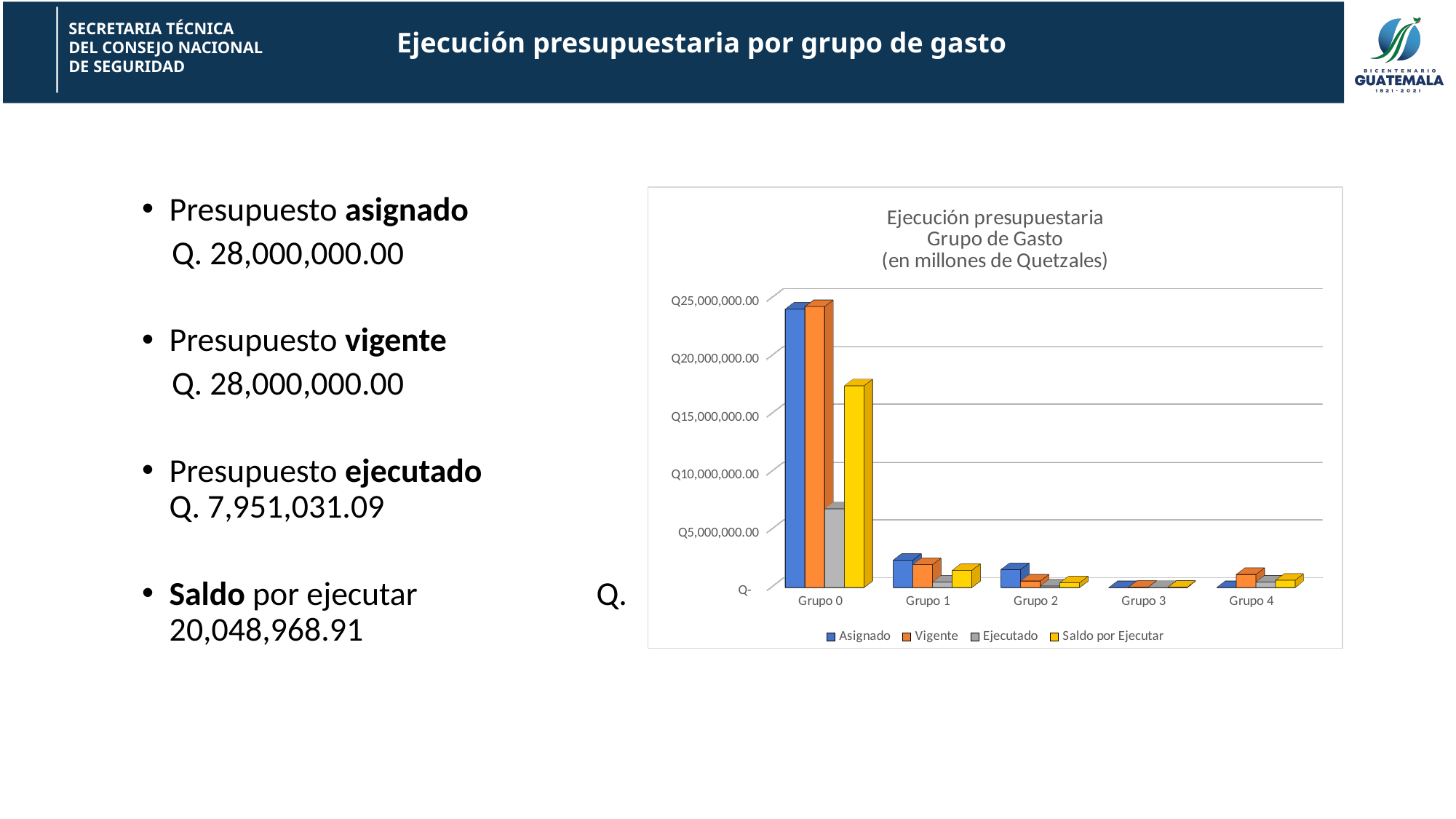
For Grupo 0, which is larger: the Vigente value or the Ejecutado value? Vigente Is the Ejecutado value for Grupo 0 greater or less than Q10,000,000.00? less What kind of chart is shown on the slide? Bar chart Which series is shown in yellow in the chart legend? Saldo por Ejecutar Is the Saldo por Ejecutar value for Grupo 0 greater or less than Q20,000,000.00? less Is the Asignado value for Grupo 1 greater or less than Q5,000,000.00? less How many groups (categories) are shown on the x axis of the chart? 5 How many series does the chart legend list? 4 What is the title of the chart? Ejecución presupuestaria Grupo de Gasto (en millones de Quetzales) Do the Asignado values rise or fall from Grupo 0 to Grupo 3? fall Which group has the highest Asignado value in the chart? Grupo 0